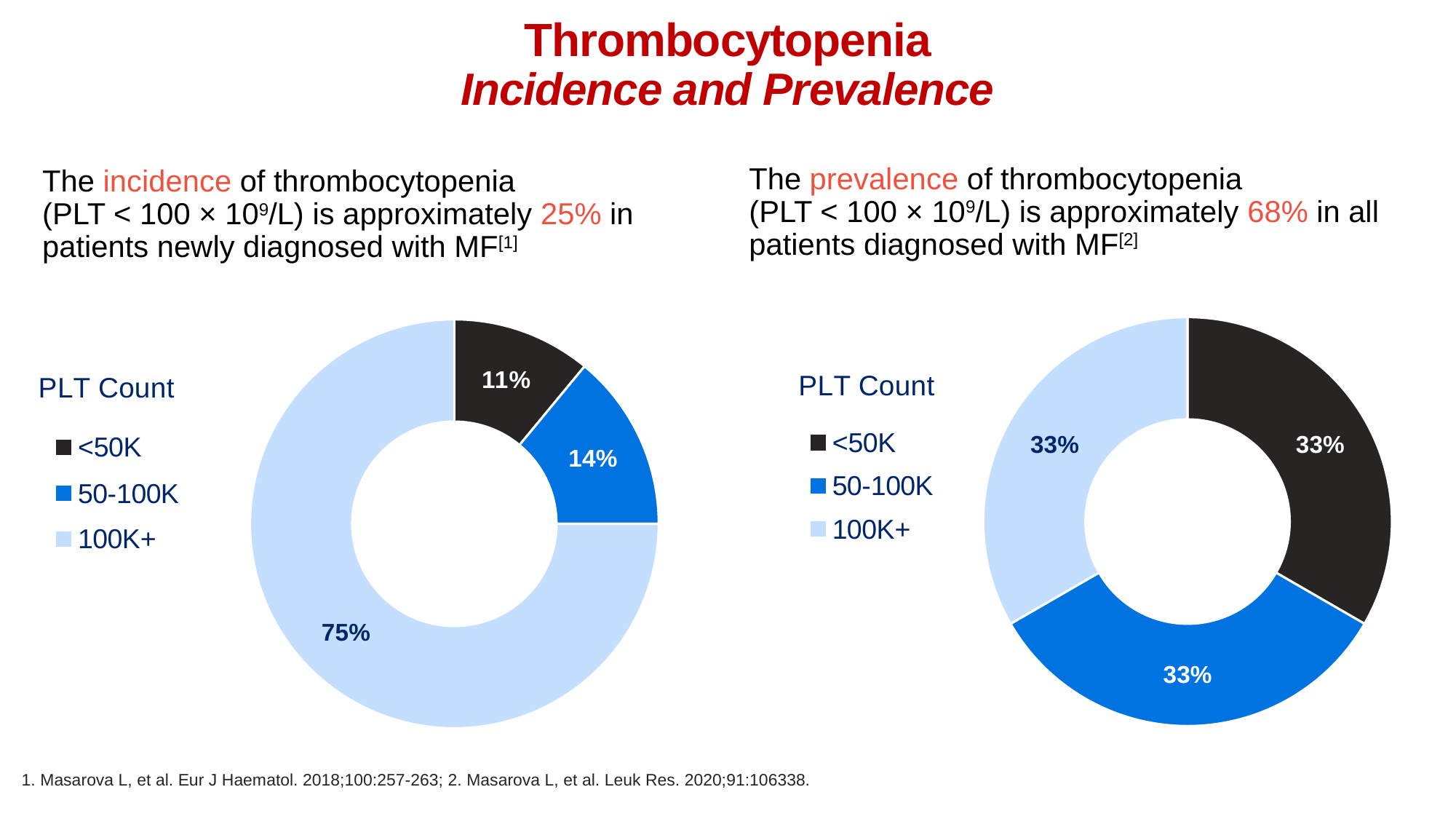
In the right (prevalence) donut chart, what percentage of patients have a PLT count of 50-100K? 33% What is the legend title of the left (incidence) donut chart? PLT Count In the left (incidence) donut chart, which is larger: the share for 50-100K or the share for <50K? 50-100K In the left (incidence) donut chart, which PLT count category has the smallest share? <50K In the left (incidence) donut chart, which PLT count category has the largest share? 100K+ In the left (incidence) donut chart, what is the difference in percentage points between the 100K+ and 50-100K categories? 61 How many categories does the legend of the right (prevalence) donut chart list? 3 In the left (incidence) donut chart, what percentage of patients have a PLT count of <50K? 11% In the left (incidence) donut chart, what percentage of patients have a PLT count of 50-100K? 14% In the left (incidence) donut chart, what percentage of patients have a PLT count of 100K+? 75% What type of chart is used on the left side of the slide? Donut (pie) chart In the right (prevalence) donut chart, what percentage of patients have a PLT count of <50K? 33%